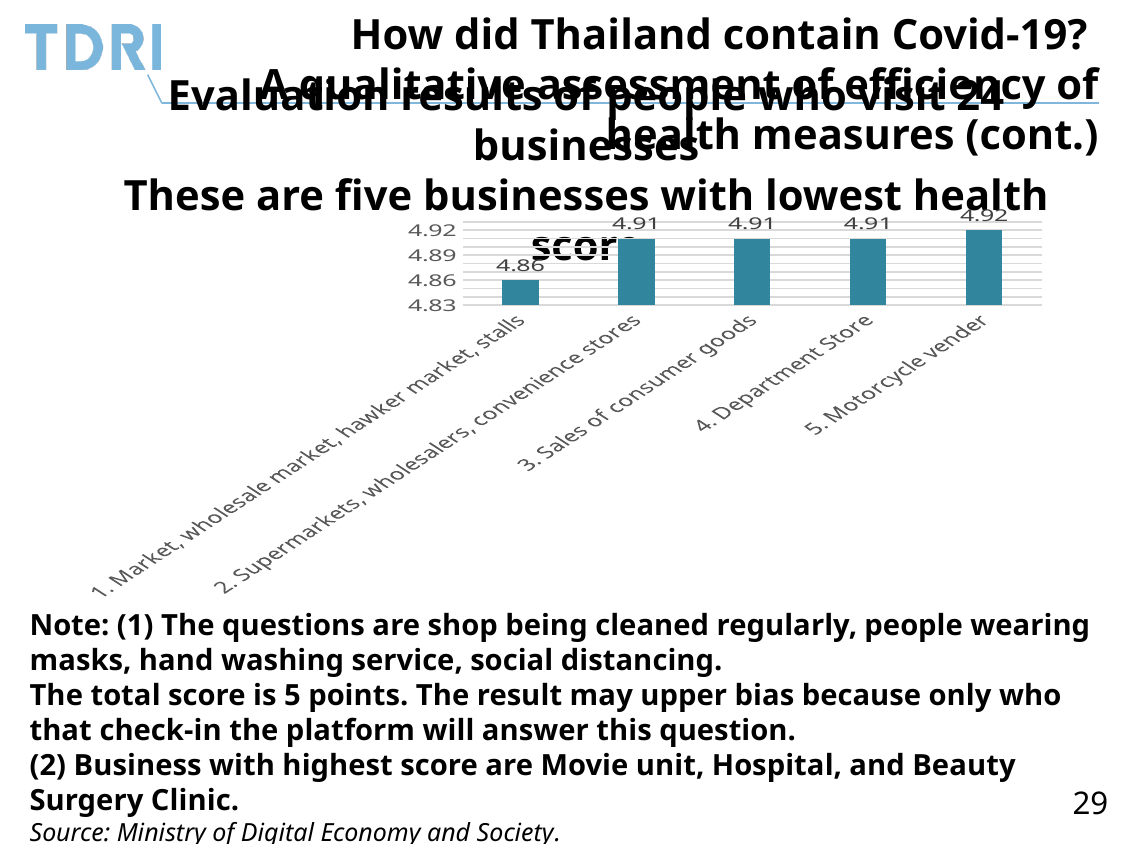
What is the difference between the health score of 5. Motorcycle vender and 1. Market, wholesale market, hawker market, stalls? 0.06 Which business has the highest health score in the chart? 5. Motorcycle vender What is the health score for 1. Market, wholesale market, hawker market, stalls? 4.86 How many businesses are shown in the chart? 5 What is the health score for 4. Department Store? 4.91 Which business has the lowest health score in the chart? 1. Market, wholesale market, hawker market, stalls Is the value for 1. Market, wholesale market, hawker market, stalls greater or less than 4.89? less Which has a higher health score: 1. Market, wholesale market, hawker market, stalls or 4. Department Store? 4. Department Store What kind of chart is shown on the slide? bar chart Do the health scores rise or fall from the first business to the last along the x axis? rise What is the health score for 5. Motorcycle vender? 4.92 What is the health score for 3. Sales of consumer goods? 4.91